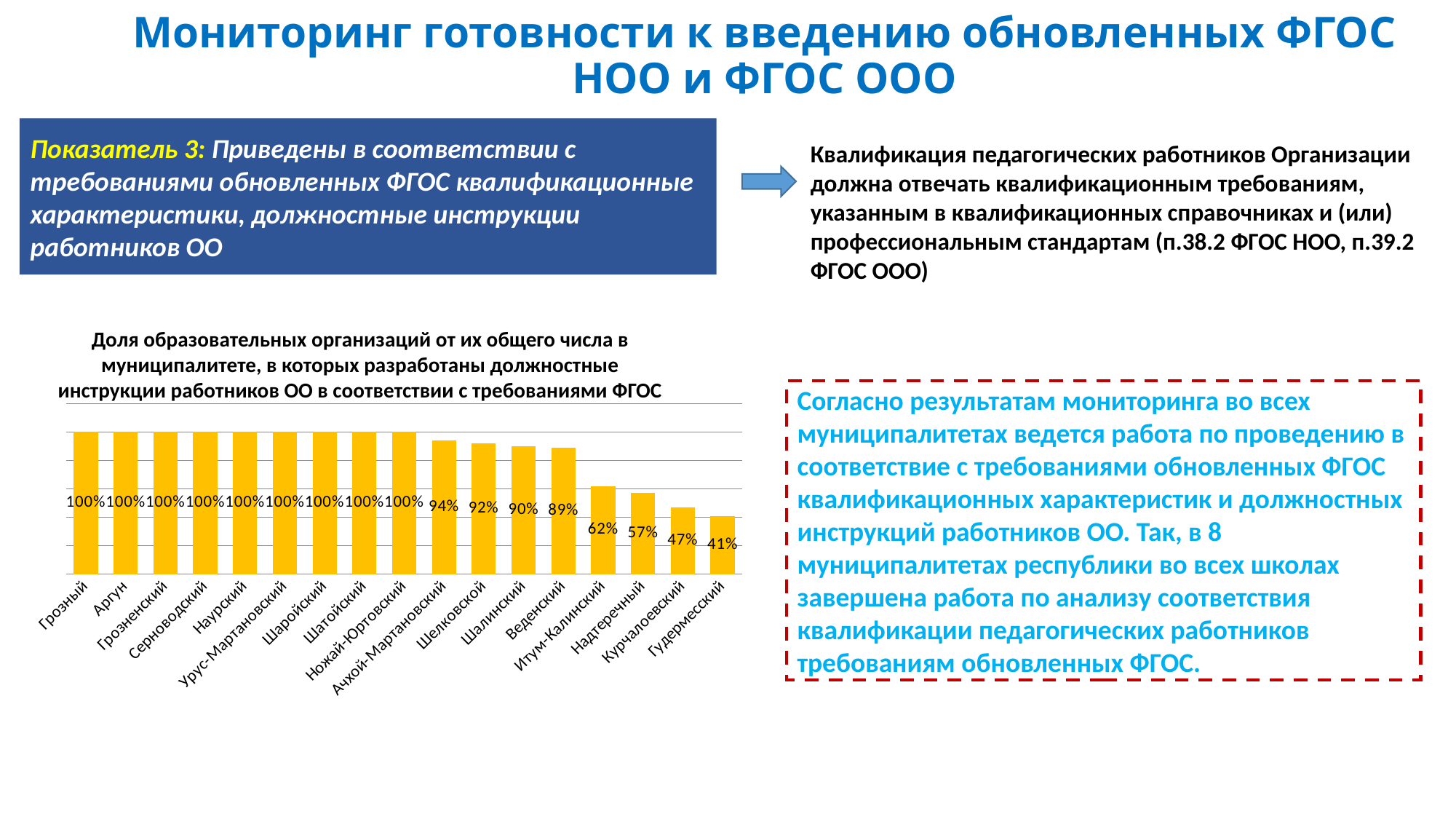
What kind of chart is shown on the slide? Bar chart What is the value for Итум-Калинский? 62% What is the difference between the values for Курчалоевский and Гудермесский? 6% What is the value for Грозный? 100% Which is larger, the value for Надтеречный or the value for Курчалоевский? Надтеречный What is the difference between the values for Итум-Калинский and Надтеречный? 5% Which category has the lowest value? Гудермесский What is the value for Гудермесский? 41% Do the values rise or fall from left to right along the x axis? Fall What colour are the bars in the chart? Yellow What is the value for Курчалоевский? 47% What is the value for Надтеречный? 57%